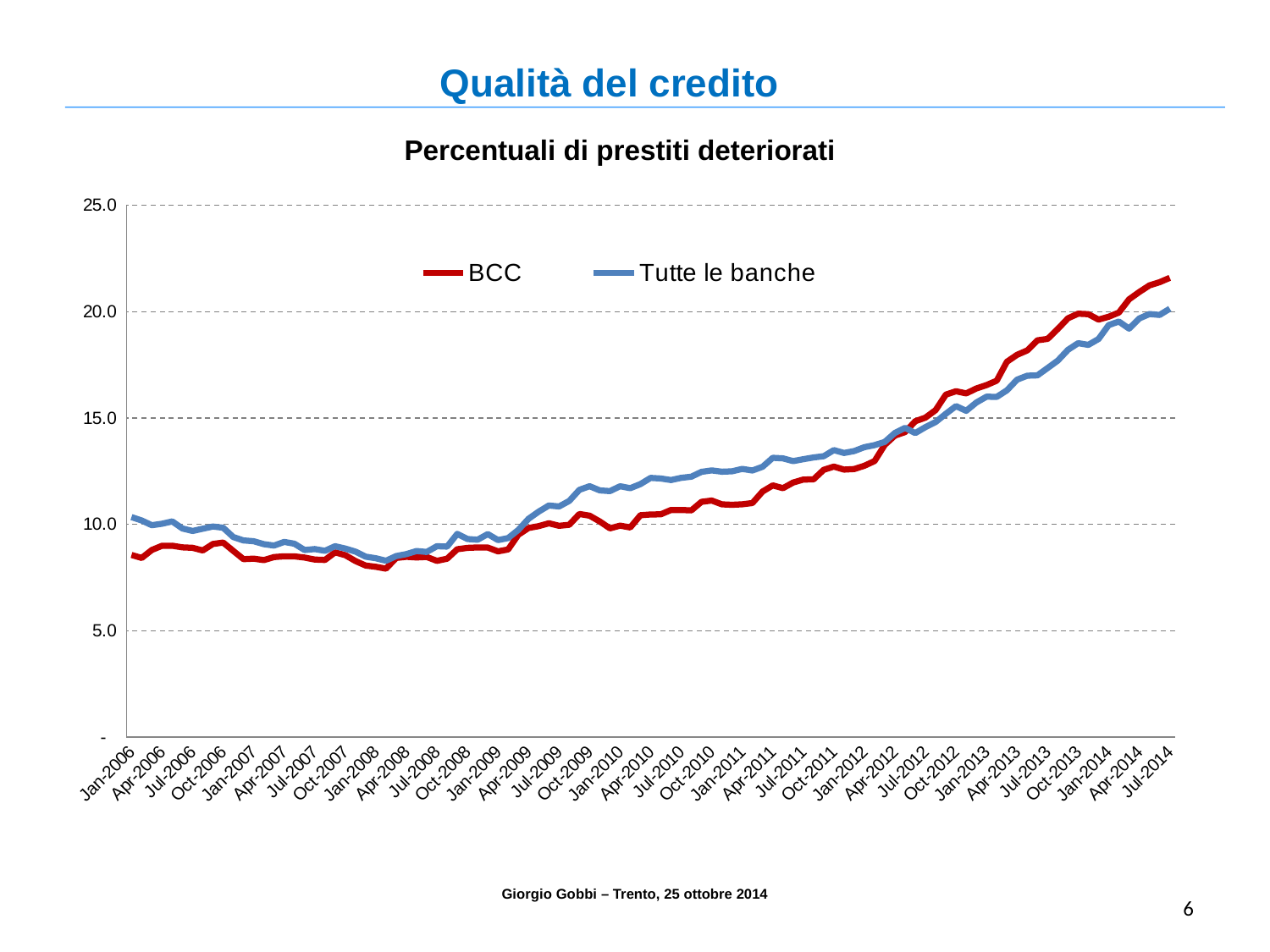
Do the values for BCC rise or fall overall from Jan-2006 to Jul-2014? rise Is the value for BCC at Jul-2014 greater or less than 20.0? greater What kind of chart is shown on the slide? line chart How many series does the legend list? 2 Do the values for Tutte le banche rise or fall overall from Jan-2006 to Jul-2014? rise What is the title of the chart? Percentuali di prestiti deteriorati At Jan-2010, which series has the higher value, BCC or Tutte le banche? Tutte le banche At Jul-2014, which series has the higher value, BCC or Tutte le banche? BCC Which series is drawn in red? BCC Is the value for BCC at Jan-2006 greater or less than 10.0? less Is the value for Tutte le banche at Jan-2014 greater or less than 15.0? greater